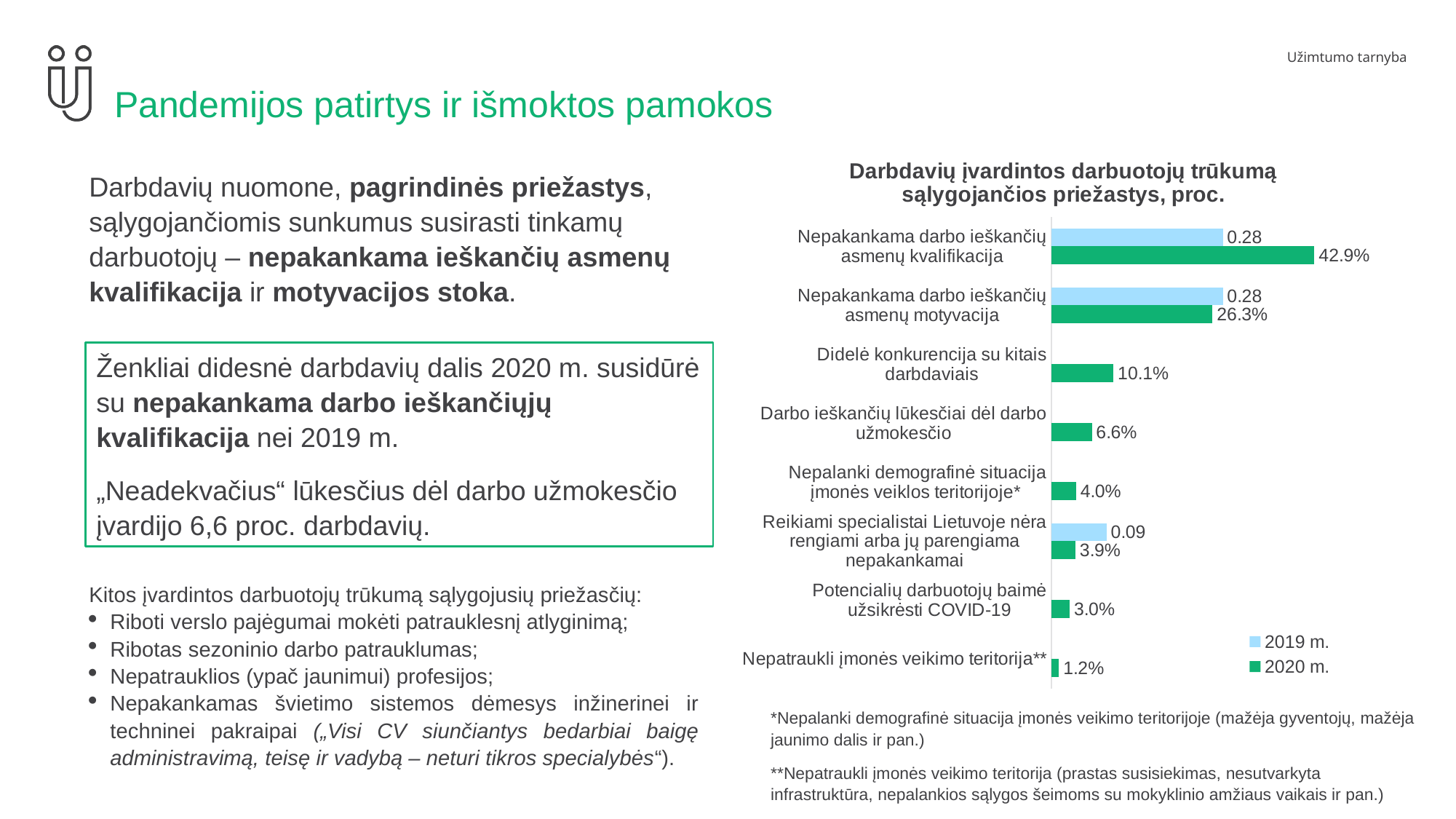
What is the 2020 m. value for "Didelė konkurencija su kitais darbdaviais"? 10.1% Which category has the highest 2020 m. value? Nepakankama darbo ieškančių asmenų kvalifikacija What is the title of the chart? Darbdavių įvardintos darbuotojų trūkumą sąlygojančios priežastys, proc. How many series does the legend list? 2 What is the 2020 m. value for "Potencialių darbuotojų baimė užsikrėsti COVID-19"? 3.0% How many categories are shown in the chart? 8 What is the 2019 m. value for "Reikiami specialistai Lietuvoje nėra rengiami arba jų parengiama nepakankamai"? 0.09 What is the 2020 m. value for "Nepakankama darbo ieškančių asmenų kvalifikacija"? 42.9% What is the difference between the 2020 m. values for "Nepakankama darbo ieškančių asmenų kvalifikacija" and "Nepakankama darbo ieškančių asmenų motyvacija"? 16.6% Which category has the lowest 2020 m. value? Nepatraukli įmonės veikimo teritorija** Which is larger in 2020 m.: "Darbo ieškančių lūkesčiai dėl darbo užmokesčio" or "Nepalanki demografinė situacija įmonės veiklos teritorijoje*"? Darbo ieškančių lūkesčiai dėl darbo užmokesčio What kind of chart is shown on the slide? Bar chart